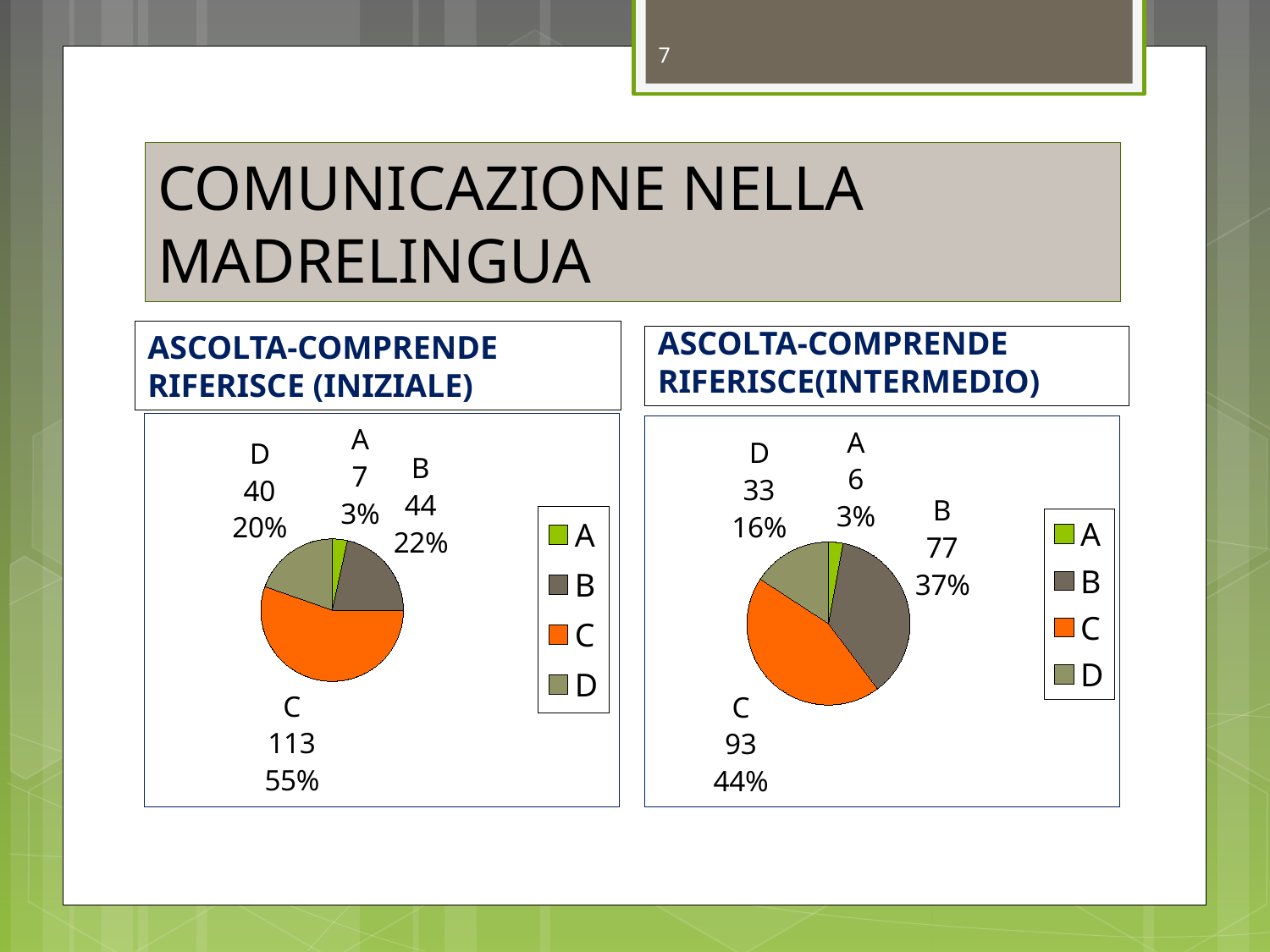
In the ASCOLTA-COMPRENDE RIFERISCE(INTERMEDIO) chart, what is the difference between the values for C and B? 16 In the ASCOLTA-COMPRENDE RIFERISCE (INIZIALE) chart, which category has the smallest slice? A In the ASCOLTA-COMPRENDE RIFERISCE(INTERMEDIO) chart, which is larger, the value for D or the value for A? D In the ASCOLTA-COMPRENDE RIFERISCE(INTERMEDIO) chart, what share of the pie does C represent? 44% In the ASCOLTA-COMPRENDE RIFERISCE (INIZIALE) chart, what is the difference between the values for B and D? 4 In the ASCOLTA-COMPRENDE RIFERISCE (INIZIALE) chart, what colour is the slice for C? Orange What kind of chart is the ASCOLTA-COMPRENDE RIFERISCE (INIZIALE) chart? Pie chart How many categories does the ASCOLTA-COMPRENDE RIFERISCE(INTERMEDIO) chart show? 4 In the ASCOLTA-COMPRENDE RIFERISCE(INTERMEDIO) chart, which category has the largest slice? C In the ASCOLTA-COMPRENDE RIFERISCE (INIZIALE) chart, what share of the pie does D represent? 20% In the ASCOLTA-COMPRENDE RIFERISCE (INIZIALE) chart, what is the value for C? 113 In the ASCOLTA-COMPRENDE RIFERISCE(INTERMEDIO) chart, what is the value for B? 77